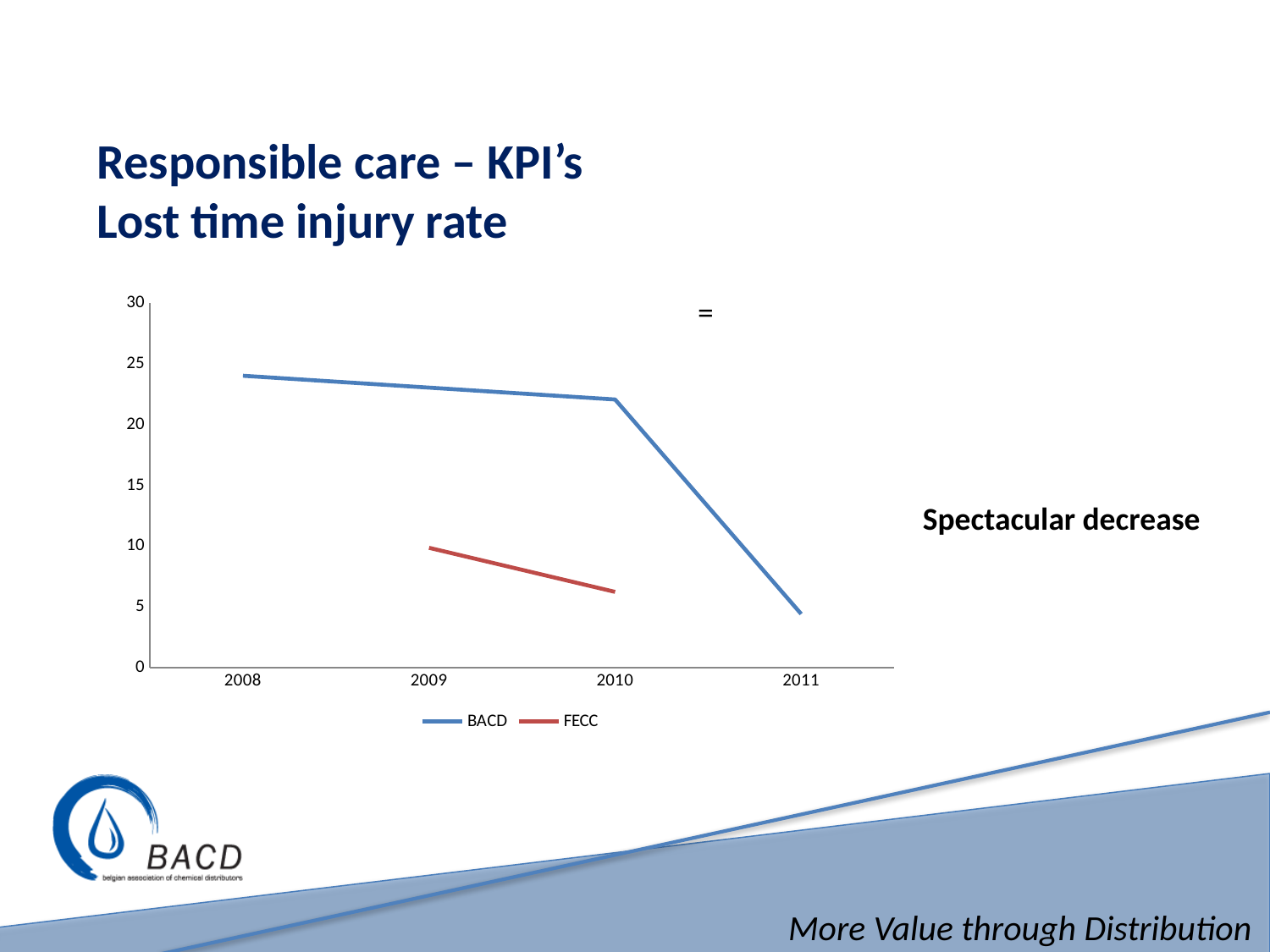
How many series does the legend list? 2 In which year is the BACD value lowest? 2011 Which series has the higher value in 2010, BACD or FECC? BACD Does the FECC line rise or fall from 2009 to 2010? fall How many years are shown on the x axis? 4 Is the BACD value for 2008 greater or less than 20? greater What kind of chart is shown on the slide? line chart Which colour is used for the FECC series? red Does the BACD line rise or fall from 2008 to 2011? fall In which year is the BACD value highest? 2008